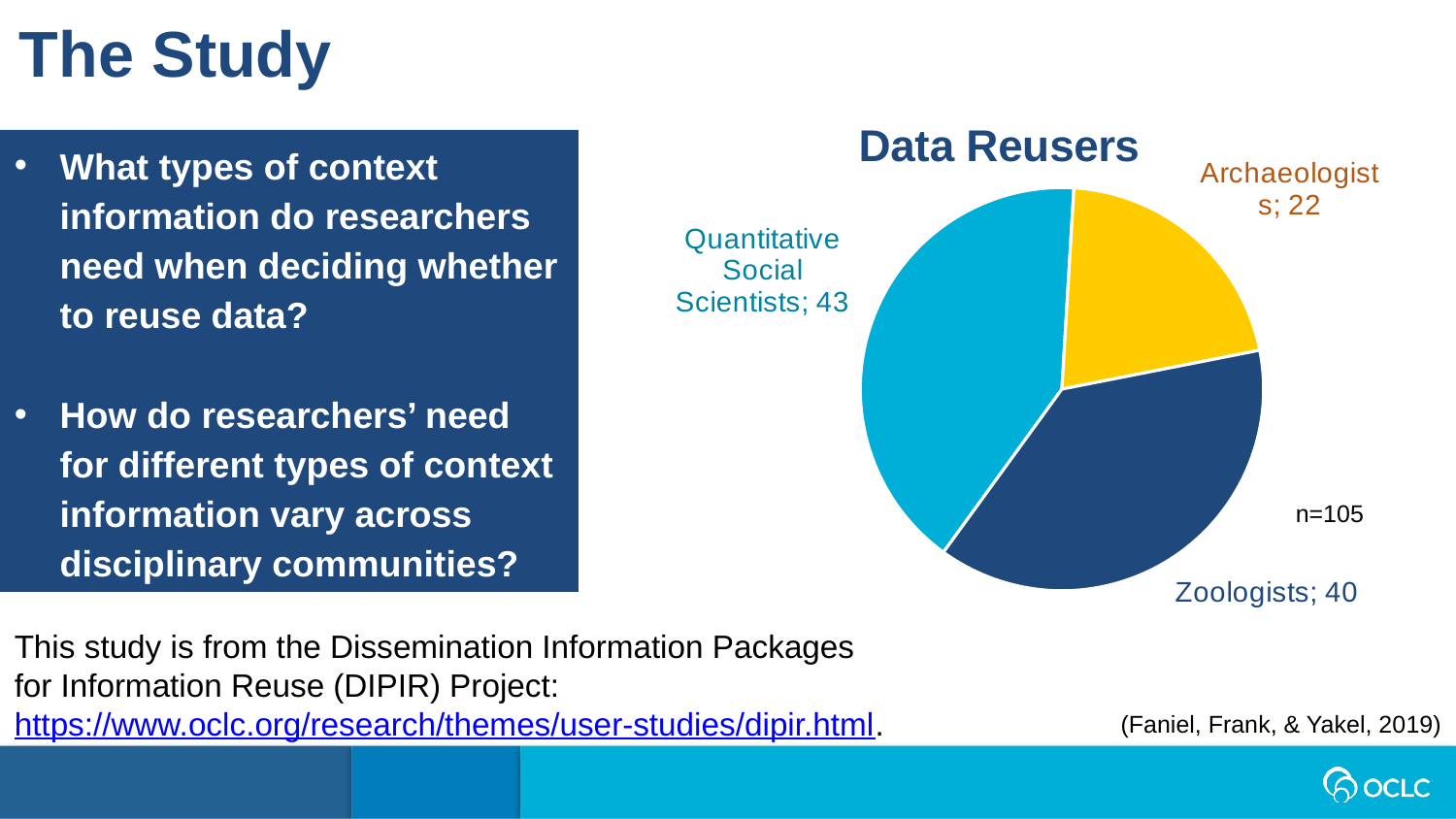
What type of chart is shown on the slide? Pie chart What is the total number of data reusers shown on the chart (n)? n=105 What is the value for Archaeologists? 22 Which is larger, the value for Zoologists or the value for Archaeologists? Zoologists What is the value for Zoologists? 40 What is the value for Quantitative Social Scientists? 43 To the nearest whole percent, what share of the pie do Archaeologists represent? 21% What is the difference between the values for Quantitative Social Scientists and Archaeologists? 21 Which group has the smallest slice of the pie? Archaeologists Which group has the largest slice of the pie? Quantitative Social Scientists How many slices does the pie chart have? 3 What is the title of the chart? Data Reusers